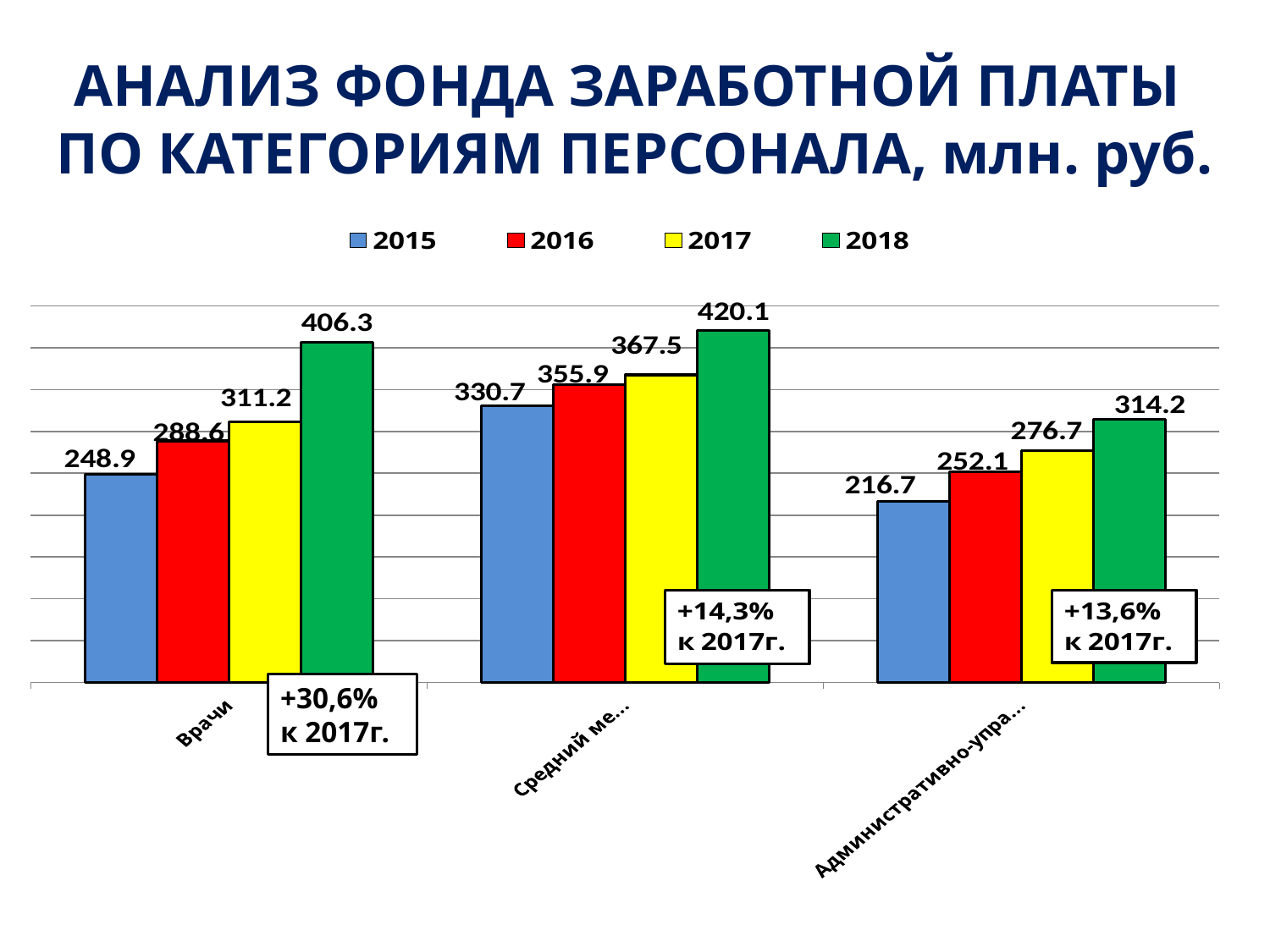
How many series does the legend list? 4 Which year has the highest value for Врачи? 2018 What is the 2016 value for the rightmost category (Административно-упра...)? 252.1 What kind of chart is shown on the slide? bar chart What is the value for Врачи in 2015? 248.9 Which is larger: the 2017 value for Врачи or the 2017 value for the rightmost category (Административно-упра...)? Врачи How many categories (groups of bars) are shown on the x axis? 3 Which year has the lowest value for the rightmost category (Административно-упра...)? 2015 What is the difference between the 2018 and 2017 values for Врачи? 95.1 What is the value for Врачи in 2018? 406.3 Do the values for the middle category (Средний ме...) rise or fall from 2015 to 2018? rise What is the 2018 value for the middle category (Средний ме...)? 420.1